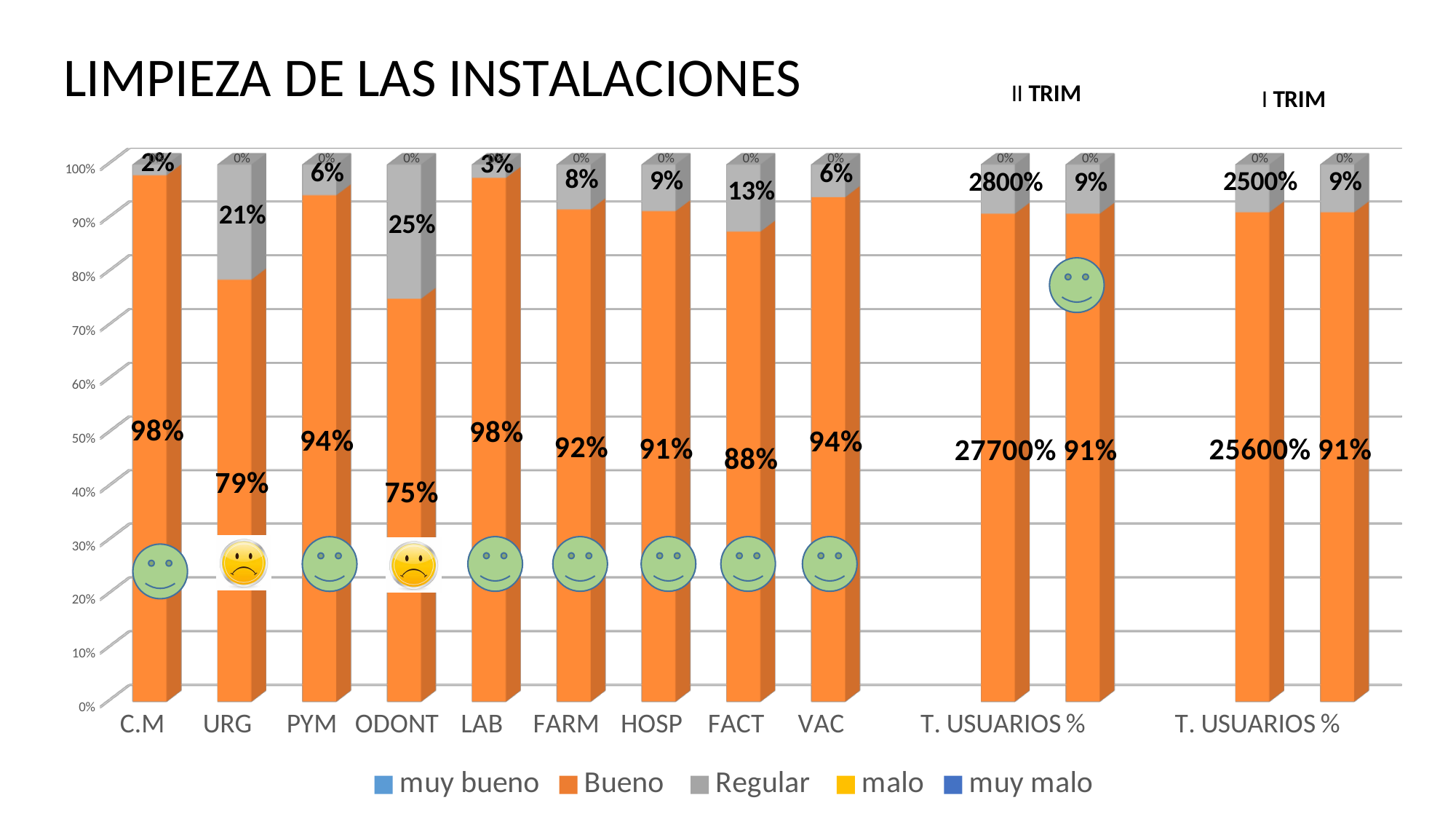
What type of chart is shown on the slide? stacked bar chart What is the difference between the Regular values for FACT and PYM? 7% What is the difference between the Bueno values for C.M and URG? 19% What is the Bueno value for URG? 79% What is the title of the chart? LIMPIEZA DE LAS INSTALACIONES Which has a larger Bueno value, FARM or FACT? FARM How many series does the legend list? 5 What is the Regular value for ODONT? 25% What is the Regular value for HOSP? 9% Which category has the lowest Bueno value? ODONT What is the Bueno value for FACT? 88%